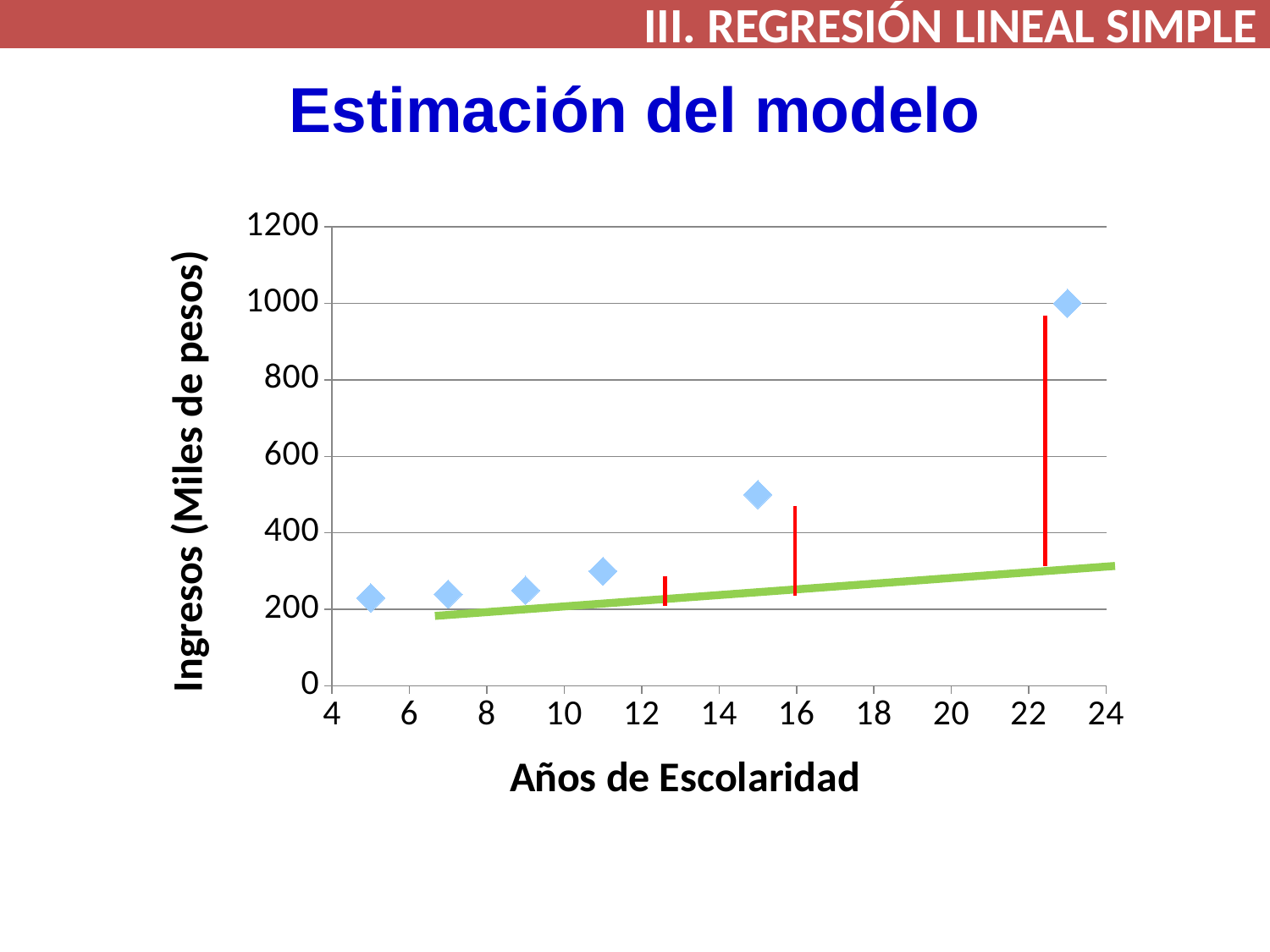
Is the Ingresos value for 15 years of schooling greater or less than 400? greater What is the title of the x axis? Años de Escolaridad At which value of Años de Escolaridad is the plotted Ingresos highest? 23 Is the Ingresos value for 23 years of schooling greater or less than 800? greater Is the Ingresos value for 11 years of schooling greater or less than 200? greater Do the plotted Ingresos values rise or fall as Años de Escolaridad increases? rise Which has a higher Ingresos value: 15 years of schooling or 11 years of schooling? 15 years What kind of chart is shown on the slide? scatter chart What is the title of the y axis? Ingresos (Miles de pesos) How many data points are plotted in the chart? 6